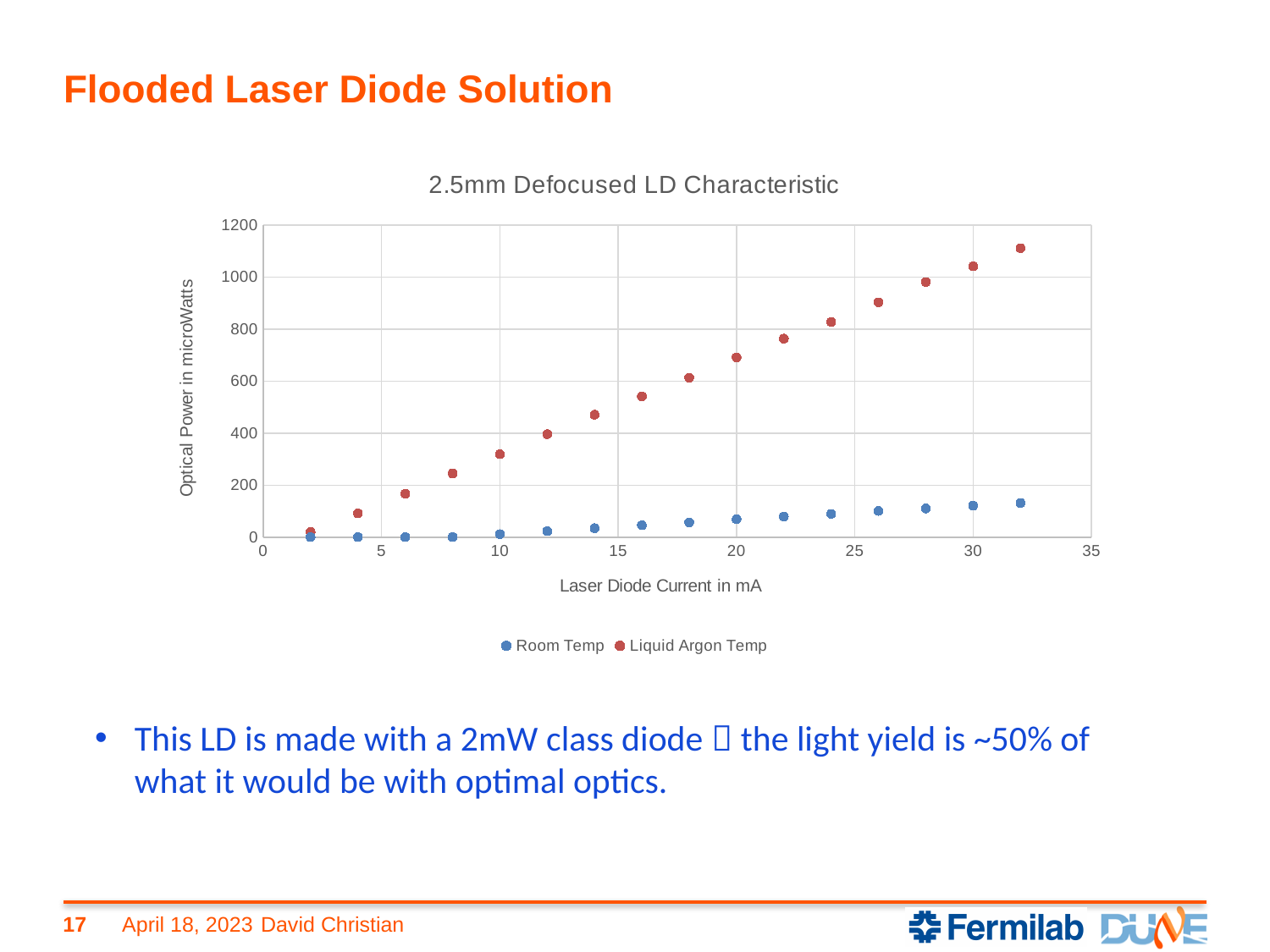
Is the Liquid Argon Temp value at 32 mA greater or less than 1000? greater How many series does the legend list? 2 How many data points are plotted for the Liquid Argon Temp series? 16 Is the Room Temp value at 32 mA greater or less than 200? less What kind of chart is shown on the slide? Scatter chart What is the label of the y axis? Optical Power in microWatts At a laser diode current of 20 mA, which series has the higher optical power, Room Temp or Liquid Argon Temp? Liquid Argon Temp Is the Liquid Argon Temp value at 20 mA greater or less than 800? less Does the optical power for the Liquid Argon Temp series rise or fall as the laser diode current increases? rise Which series reaches the highest optical power on the chart? Liquid Argon Temp What is the title of the chart? 2.5mm Defocused LD Characteristic